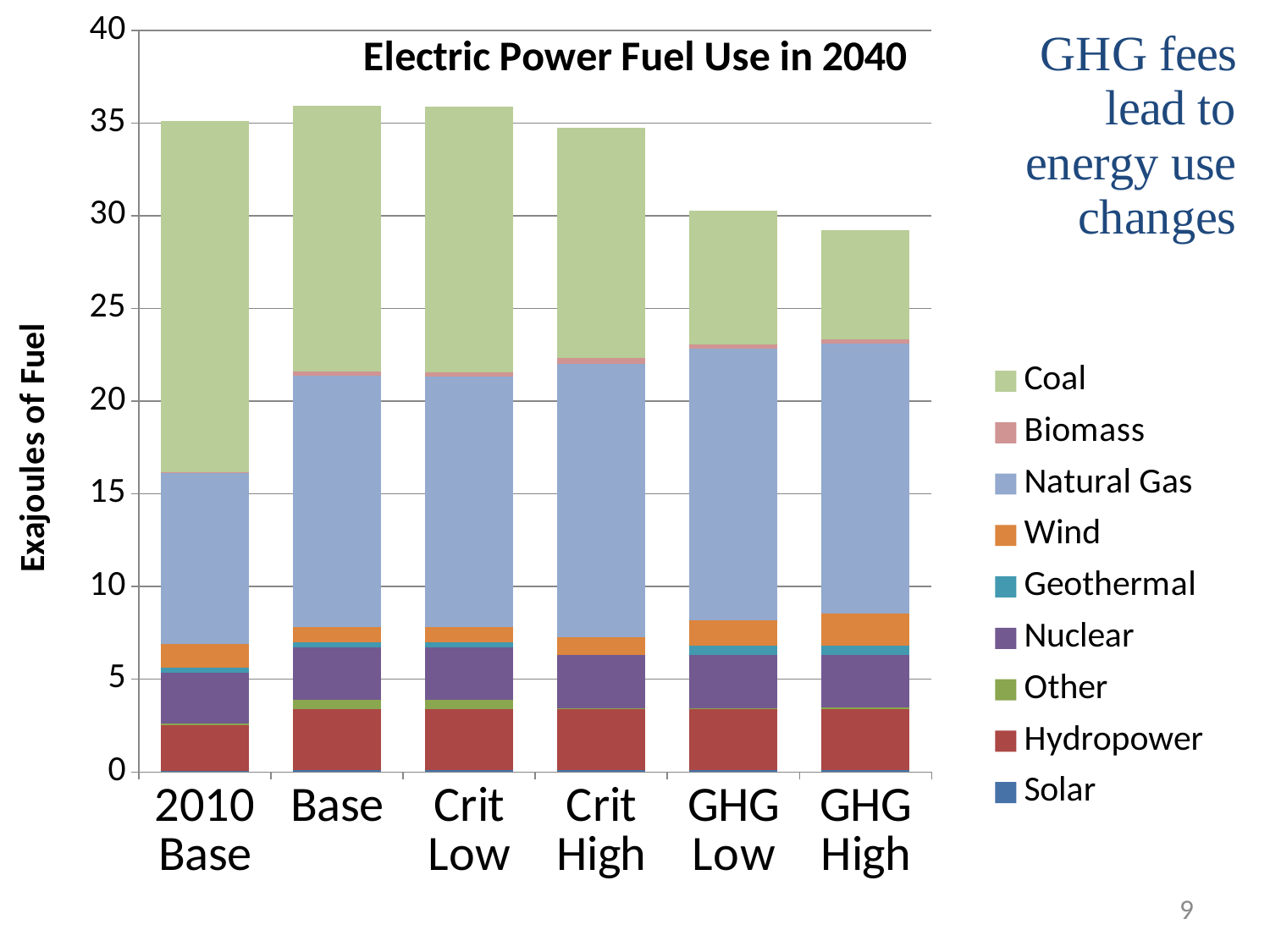
Is the total fuel use for Base greater or less than 35 exajoules? greater Is the Natural Gas segment for 2010 Base greater or less than 10 exajoules? less Which scenario has the larger Coal segment, 2010 Base or GHG High? 2010 Base What is the title of the chart? Electric Power Fuel Use in 2040 Is the Coal segment for 2010 Base greater or less than 15 exajoules? greater Which has the larger total fuel use, GHG Low or GHG High? GHG Low How many series does the legend list? 9 How many scenarios (categories) are shown along the x axis? 6 Do the total bar heights rise or fall from Crit Low to GHG High? fall What kind of chart is shown on the slide? Stacked bar chart Which scenario has the lowest total electric power fuel use? GHG High